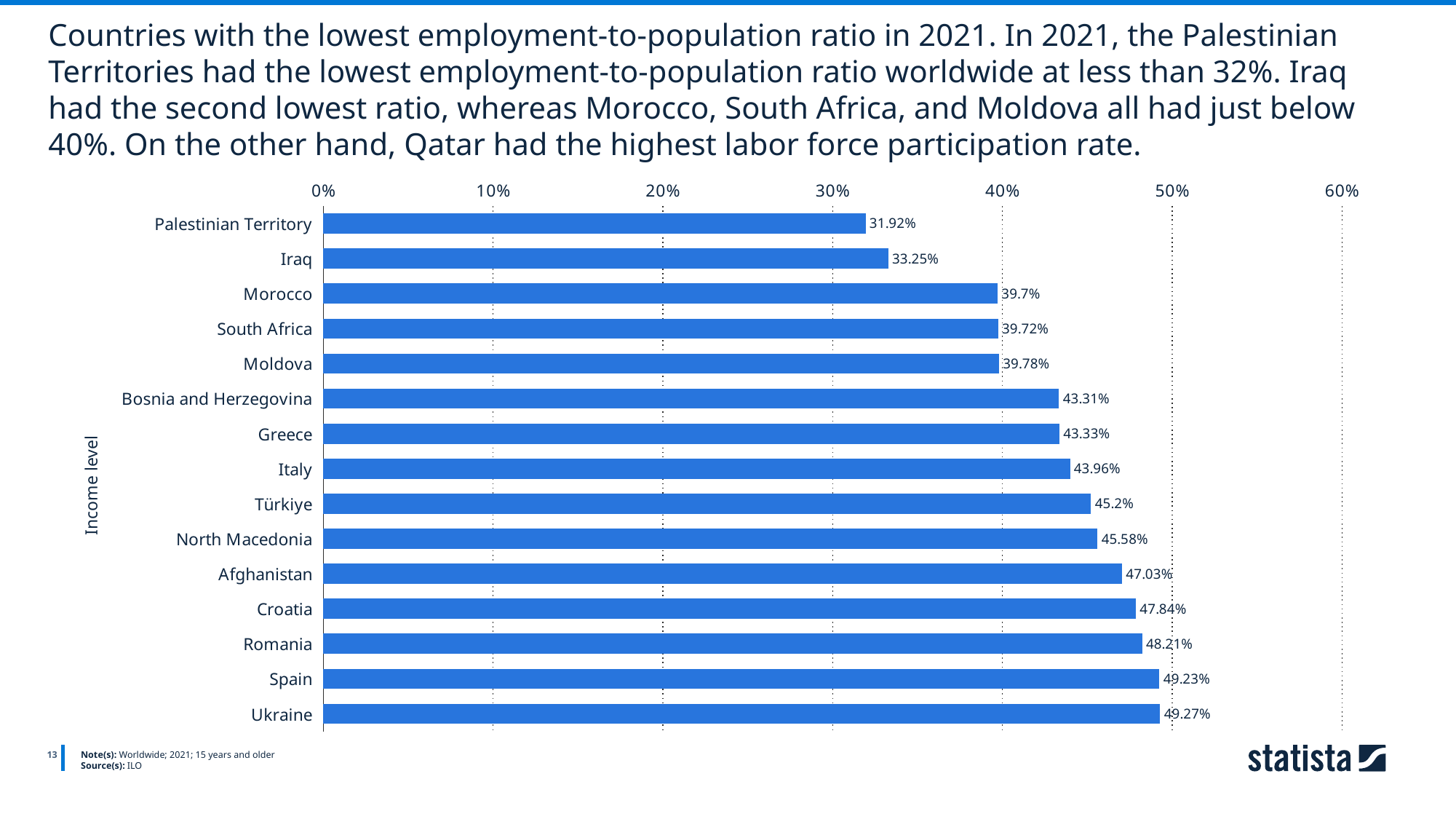
Which has a higher value, Italy or Greece? Italy What value is shown for Türkiye? 45.2% What is the employment-to-population ratio shown for Iraq? 33.25% What value is shown for Bosnia and Herzegovina? 43.31% Which country has the lowest employment-to-population ratio on the chart? Palestinian Territory How many countries are shown on the chart? 15 Is the value for Afghanistan greater or less than 40%? greater What is the label on the vertical axis of the chart? Income level What is the difference between the values for Spain and Croatia? 1.39 percentage points What is the difference between the values for Iraq and Palestinian Territory? 1.33 percentage points What is the value shown for Romania? 48.21% What kind of chart is shown on the slide? Bar chart